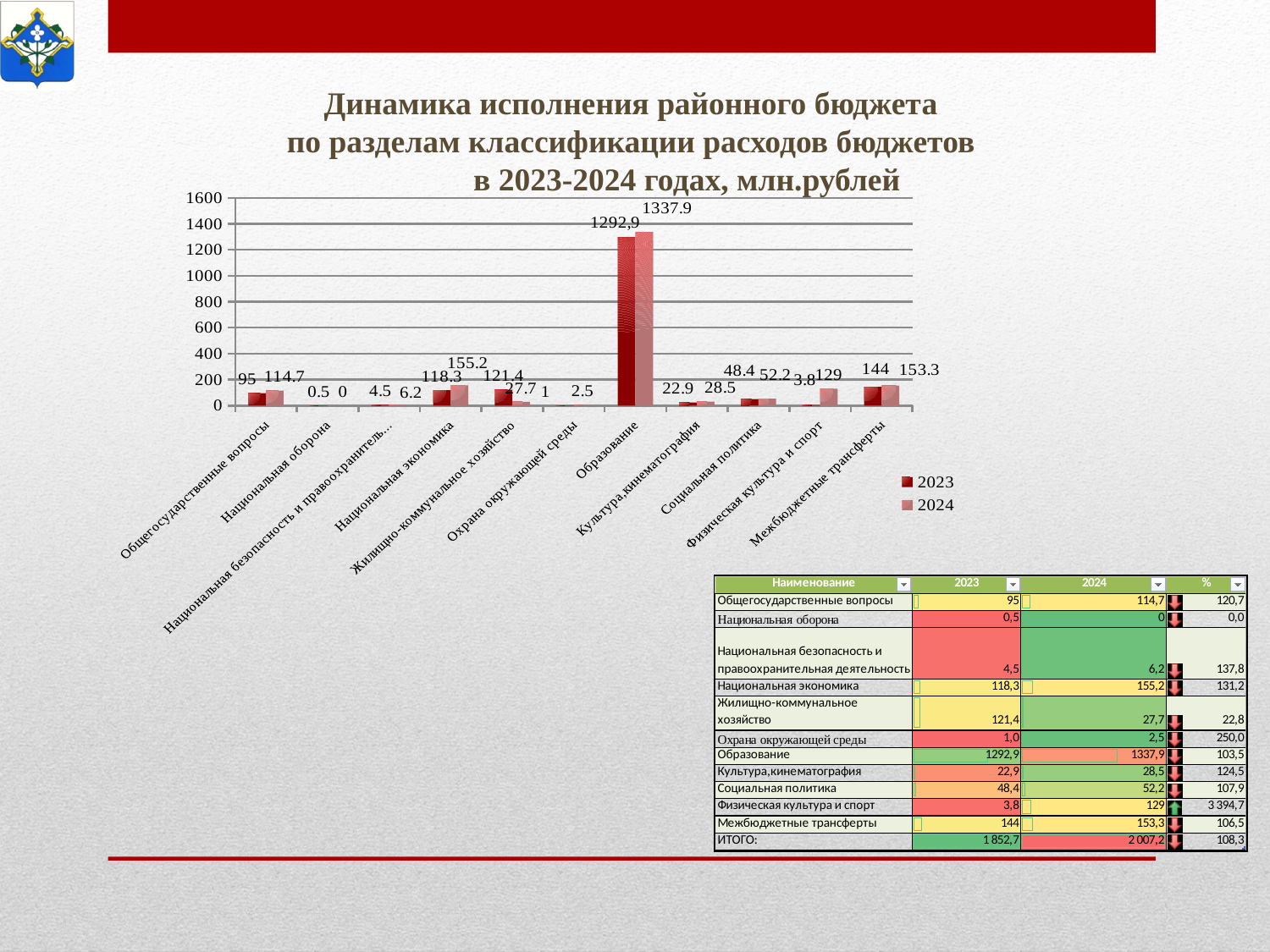
How many categories are shown on the x axis of the chart? 11 Which category has the lowest value in 2024? Национальная оборона What is the value for Национальная экономика in 2023? 118.3 What is the value for Межбюджетные трансферты in 2023? 144 Which is larger for Жилищно-коммунальное хозяйство: the 2023 value or the 2024 value? 2023 What is the value for Физическая культура и спорт in 2024? 129 Which series is shown in the darker red colour in the legend? 2023 Which category has the highest value in 2024? Образование What is the value for Образование in 2024? 1337.9 What is the difference between the 2024 and 2023 values for Общегосударственные вопросы? 19.7 What type of chart is shown on the slide? bar chart How many series does the chart legend list? 2